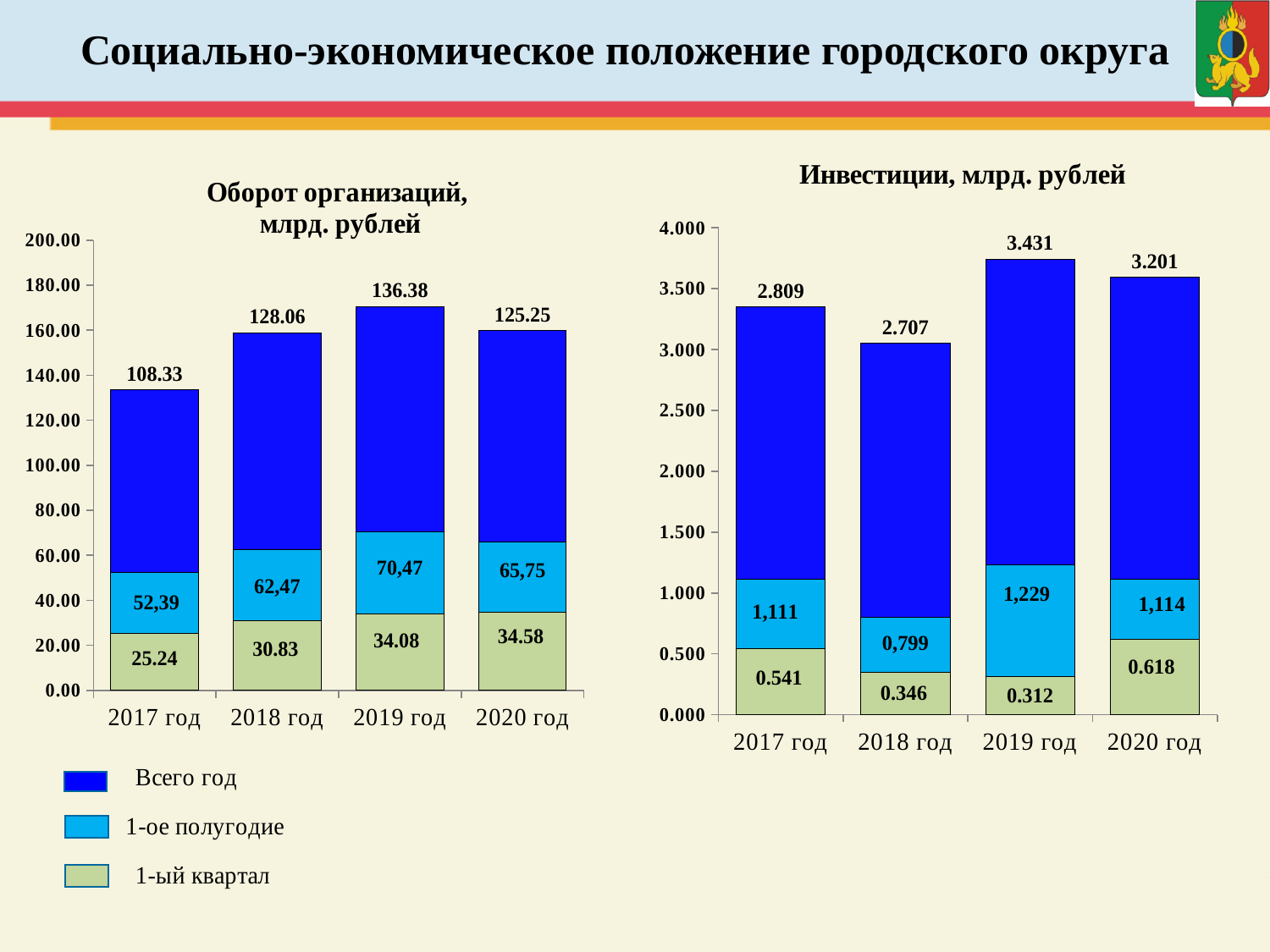
In the chart 'Инвестиции, млрд. рублей', which year has the lowest '1-ый квартал' value? 2019 год How many series does the legend on the slide list? 3 In the chart 'Инвестиции, млрд. рублей', which is larger: the 'Всего год' value for 2017 год or for 2018 год? 2017 год In the chart 'Инвестиции, млрд. рублей', what is the value for 'Всего год' in 2020 год? 3.201 How many years are shown on the x axis of the chart 'Оборот организаций, млрд. рублей'? 4 In the chart 'Оборот организаций, млрд. рублей', what is the value for '1-ое полугодие' in 2020 год? 65,75 In the chart 'Оборот организаций, млрд. рублей', what is the value for '1-ый квартал' in 2017 год? 25.24 In the chart 'Оборот организаций, млрд. рублей', which year has the highest 'Всего год' value? 2019 год In the chart 'Оборот организаций, млрд. рублей', what is the value for 'Всего год' in 2019 год? 136.38 In the chart 'Инвестиции, млрд. рублей', what is the difference between the 'Всего год' values for 2019 год and 2018 год? 0.724 In the chart 'Инвестиции, млрд. рублей', what is the value for '1-ый квартал' in 2019 год? 0.312 In the chart 'Оборот организаций, млрд. рублей', what is the difference between the 'Всего год' values for 2019 год and 2017 год? 28.05